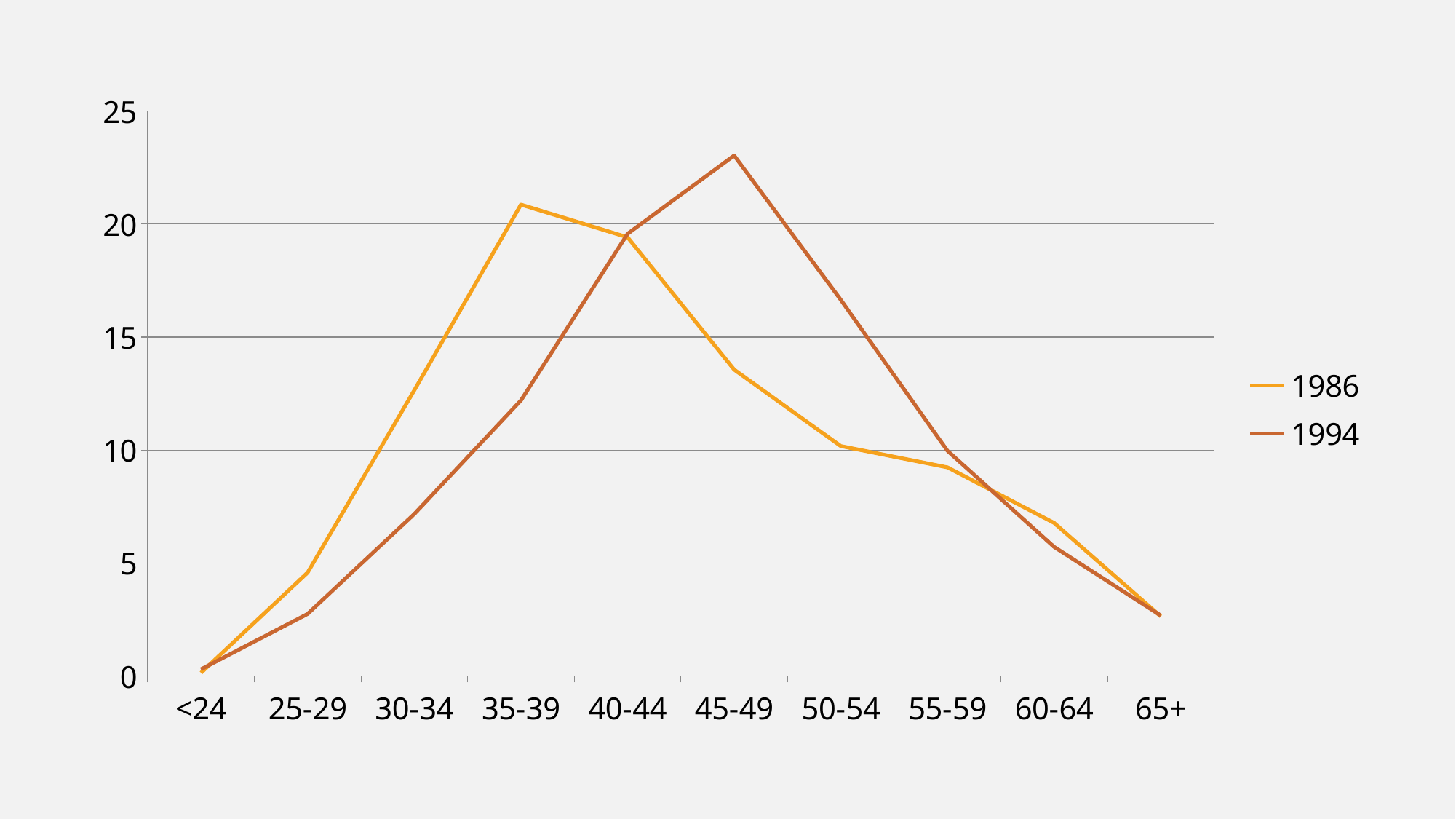
Which series has the larger value for the 45-49 age category, 1986 or 1994? 1994 How many series does the legend list? 2 Is the value for 1986 in the 25-29 age category greater or less than 5? less Which series has the larger value for the 30-34 age category, 1986 or 1994? 1986 What kind of chart is shown on the slide? line chart Which age category has the highest value for the 1986 series? 35-39 How many age categories are shown on the x axis? 10 Which age category has the lowest value for the 1994 series? <24 What are the two entries listed in the legend? 1986 and 1994 Is the value for 1994 in the 45-49 age category greater or less than 20? greater Which age category has the highest value for the 1994 series? 45-49 Does the 1994 series rise or fall from the 45-49 category to the 65+ category? fall